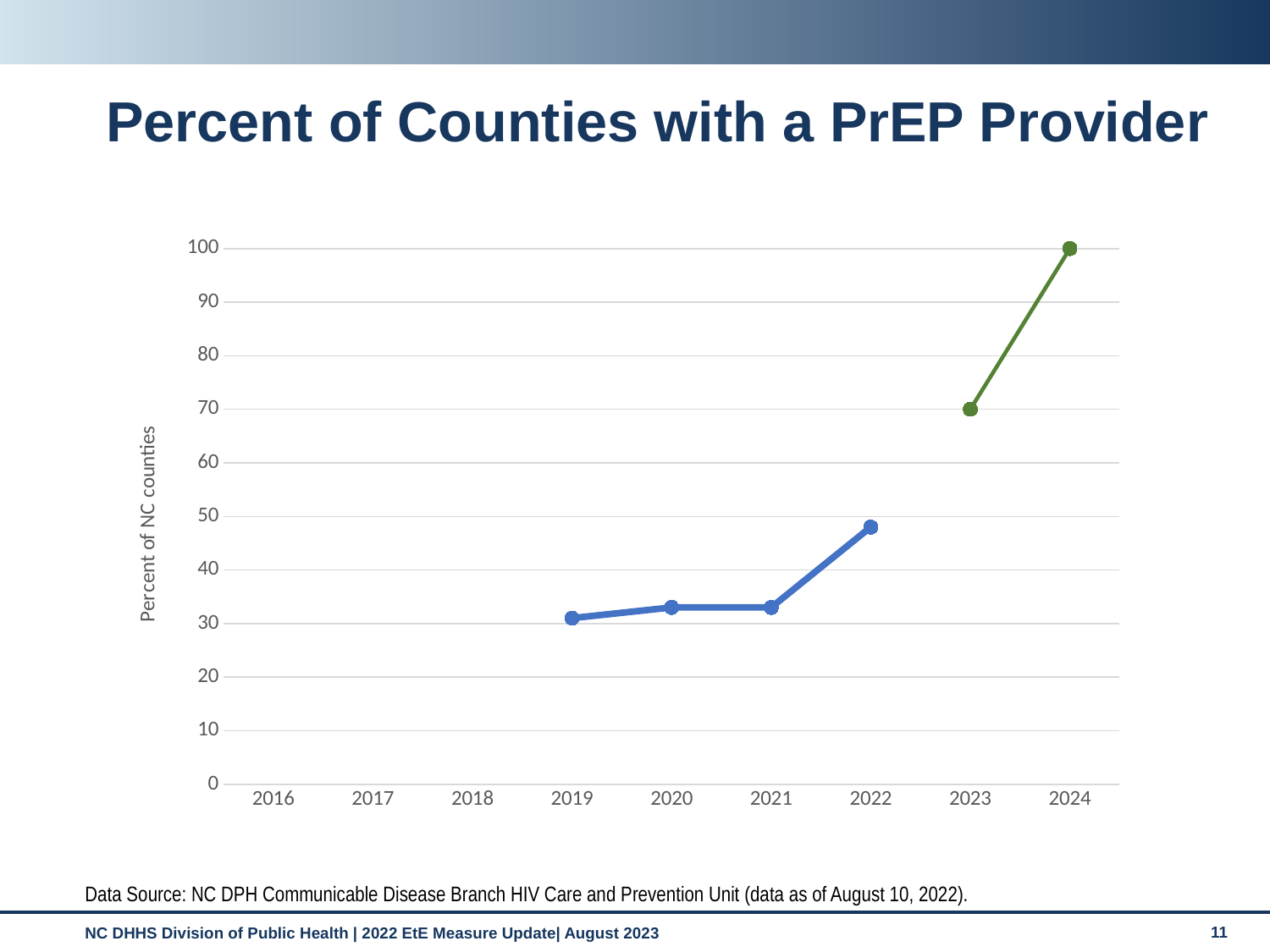
How many data points are plotted on the chart? 6 What is the percent of NC counties with a PrEP provider plotted for 2023? 70 What is the label on the vertical axis of the chart? Percent of NC counties What is the percent of NC counties with a PrEP provider plotted for 2024? 100 What kind of chart is shown on the slide? line chart Do the plotted values rise or fall from 2019 to 2024? rise Which year has the highest plotted value? 2024 Is the value for 2022 greater or less than 50? less Is the value for 2022 greater or less than 40? greater Which year has the larger plotted value, 2021 or 2022? 2022 What is the difference between the values plotted for 2024 and 2023? 30